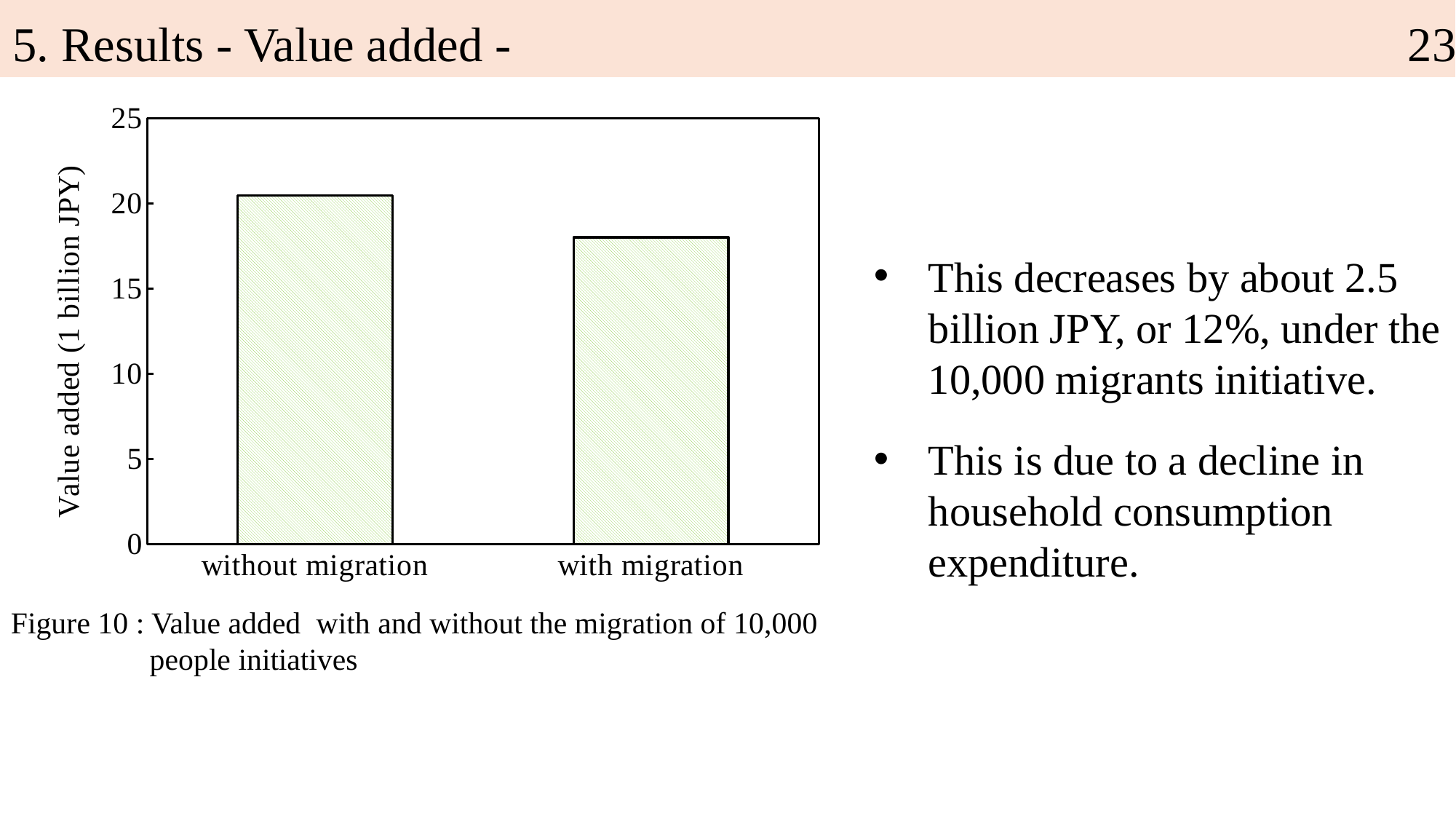
Which category has the highest value added? without migration What is the label of the y axis of the chart? Value added (1 billion JPY) What figure number is given in the caption below the chart? Figure 10 Is the value for with migration greater or less than 15? greater What kind of chart is shown on the slide? bar chart Do the values rise or fall from without migration to with migration? fall Which is larger, the value added without migration or with migration? without migration Is the value for without migration greater or less than 20? greater Is the value for with migration greater or less than 20? less Which category has the lowest value added? with migration How many categories are plotted on the x axis of the chart? 2